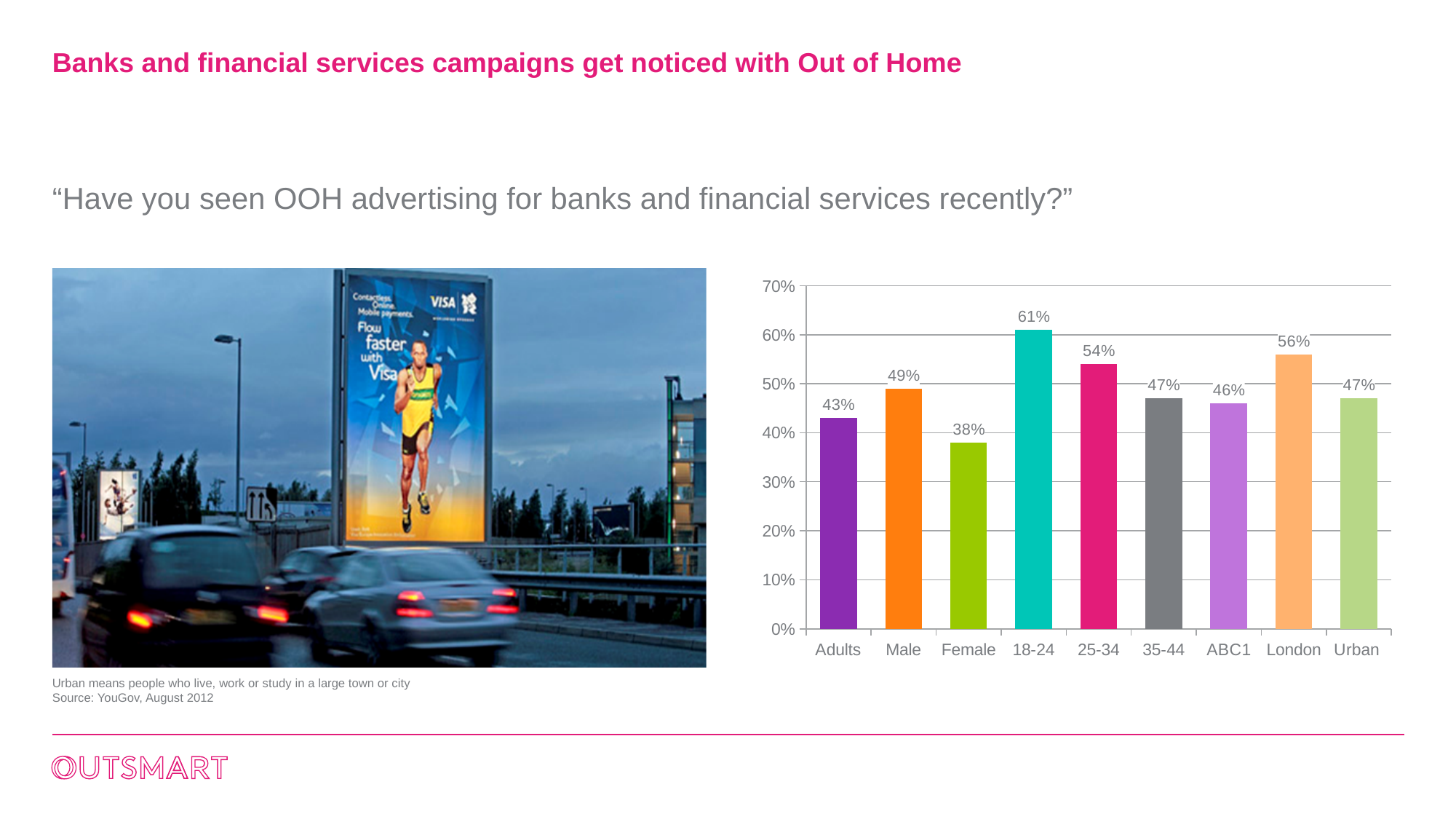
How many categories are shown on the x axis of the chart? 9 Which has a higher value, 25-34 or 35-44? 25-34 What is the value shown for the 18-24 age group? 61% What kind of chart is shown on the slide? bar chart Which category has the highest value in the chart? 18-24 What percentage of Adults said they had seen OOH advertising for banks and financial services recently? 43% Which category has the lowest value in the chart? Female Is the value for ABC1 greater or less than 50%? less What is the difference between the Male and Female values? 11% What is the value shown for Female? 38% What is the value shown for London? 56% What is the source cited for the chart data? YouGov, August 2012